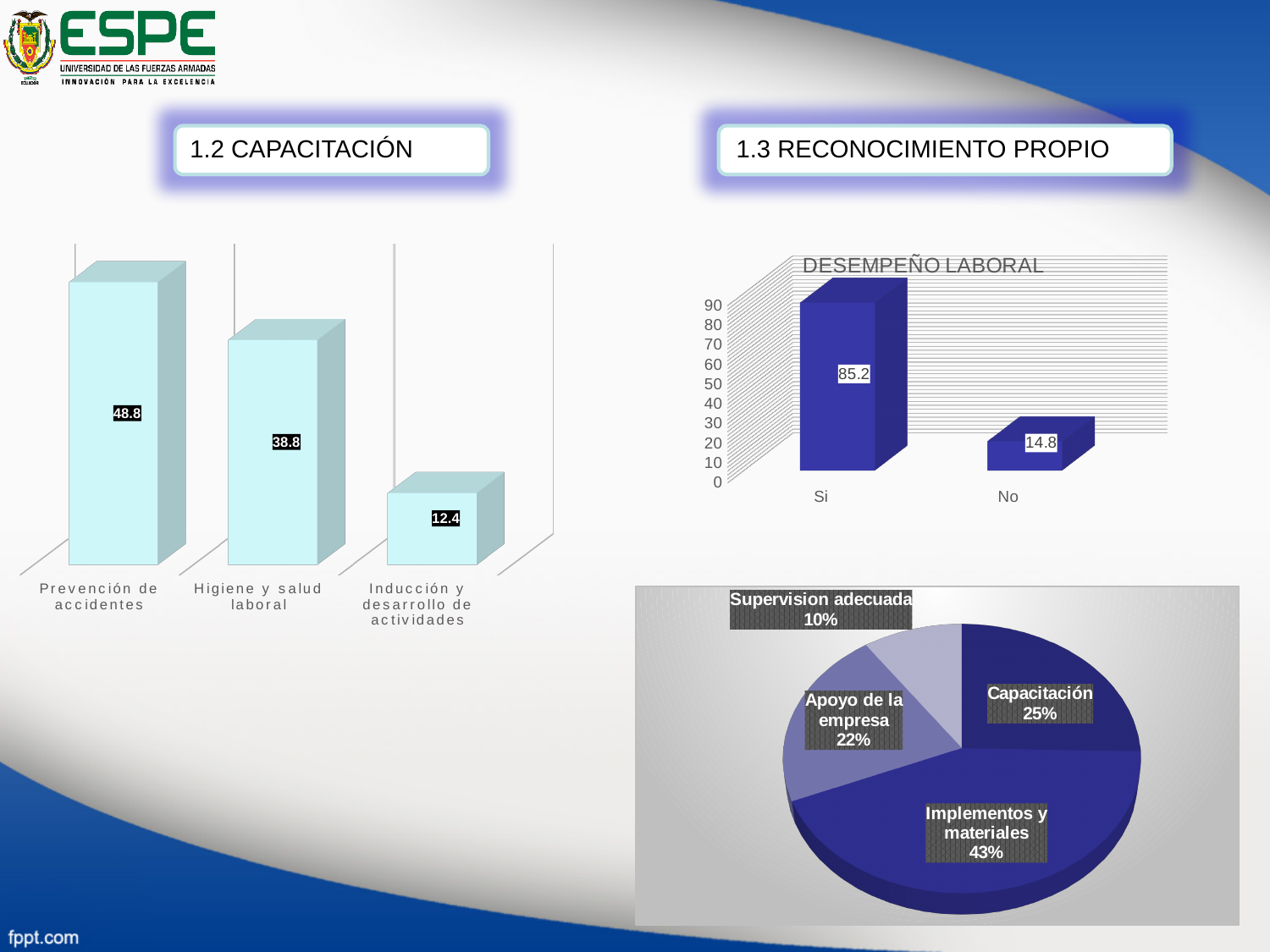
In the DESEMPEÑO LABORAL chart, what is the value for Si? 85.2 In the bar chart on the left under 1.2 CAPACITACIÓN, what is the difference between Prevención de accidentes and Higiene y salud laboral? 10 In the bar chart on the left under 1.2 CAPACITACIÓN, which category has the highest value? Prevención de accidentes In the bar chart on the left under 1.2 CAPACITACIÓN, how many categories are shown? 3 In the pie chart at the bottom right, which slice is the smallest? Supervision adecuada In the pie chart at the bottom right, how many slices are there? 4 In the DESEMPEÑO LABORAL chart, what is the value for No? 14.8 In the bar chart on the left under 1.2 CAPACITACIÓN, what is the value for Prevención de accidentes? 48.8 What kind of chart is the DESEMPEÑO LABORAL chart? Bar chart In the bar chart on the left under 1.2 CAPACITACIÓN, what is the value for Inducción y desarrollo de actividades? 12.4 In the DESEMPEÑO LABORAL chart, what is the difference between Si and No? 70.4 In the pie chart at the bottom right, what share does Implementos y materiales have? 43%